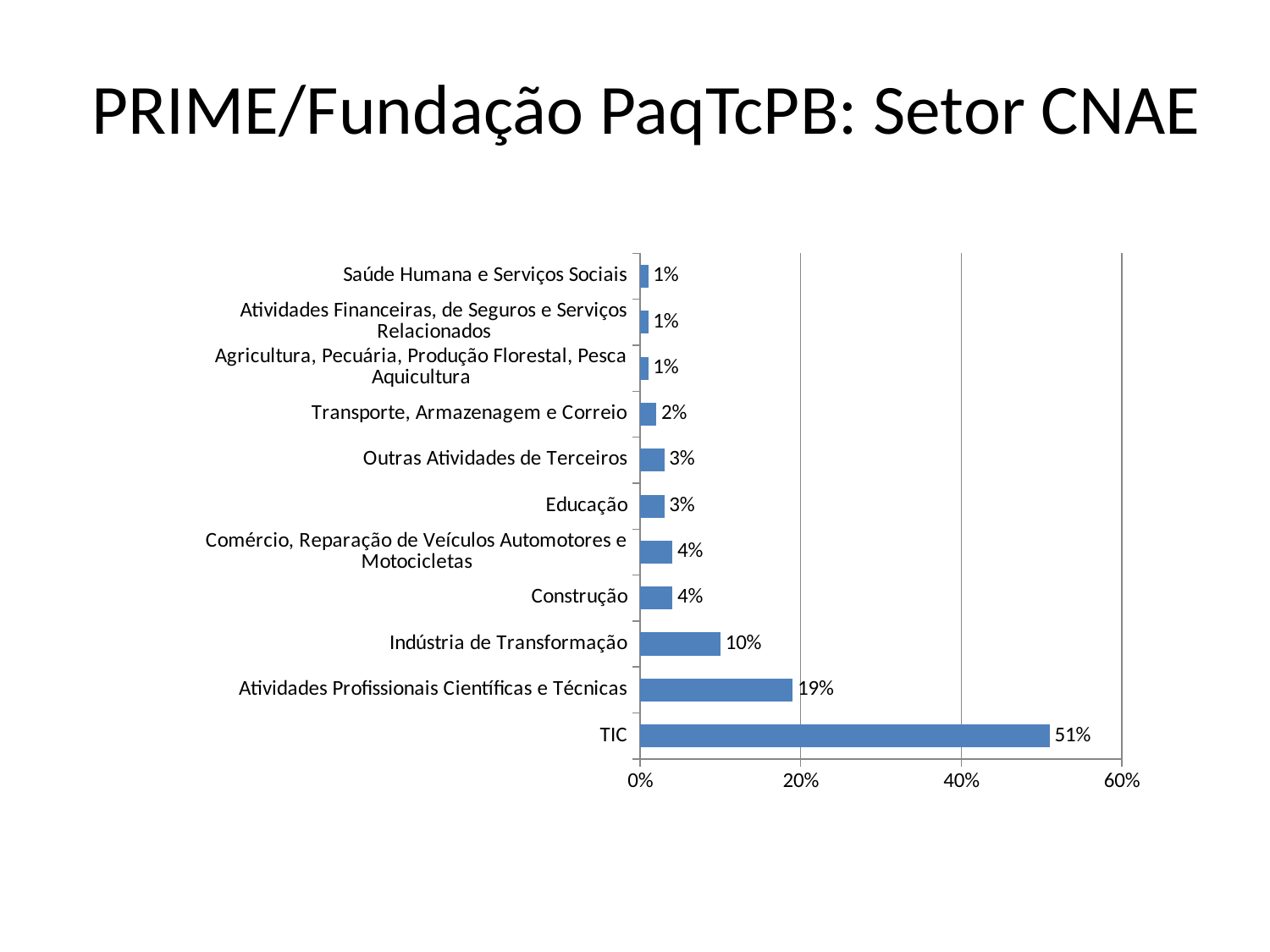
What is the value for TIC? 51% How many categories are shown in the chart? 11 What kind of chart is shown on the slide? bar chart What is the value for Transporte, Armazenagem e Correio? 2% What is the difference between the values for TIC and Atividades Profissionais Científicas e Técnicas? 32% What is the value for Atividades Profissionais Científicas e Técnicas? 19% Is the value for TIC greater or less than 40%? greater What is the title of the slide? PRIME/Fundação PaqTcPB: Setor CNAE Which is larger, the value for Educação or the value for Indústria de Transformação? Indústria de Transformação Which category has the highest value? TIC What is the value for Indústria de Transformação? 10% What is the difference between the values for Indústria de Transformação and Construção? 6%